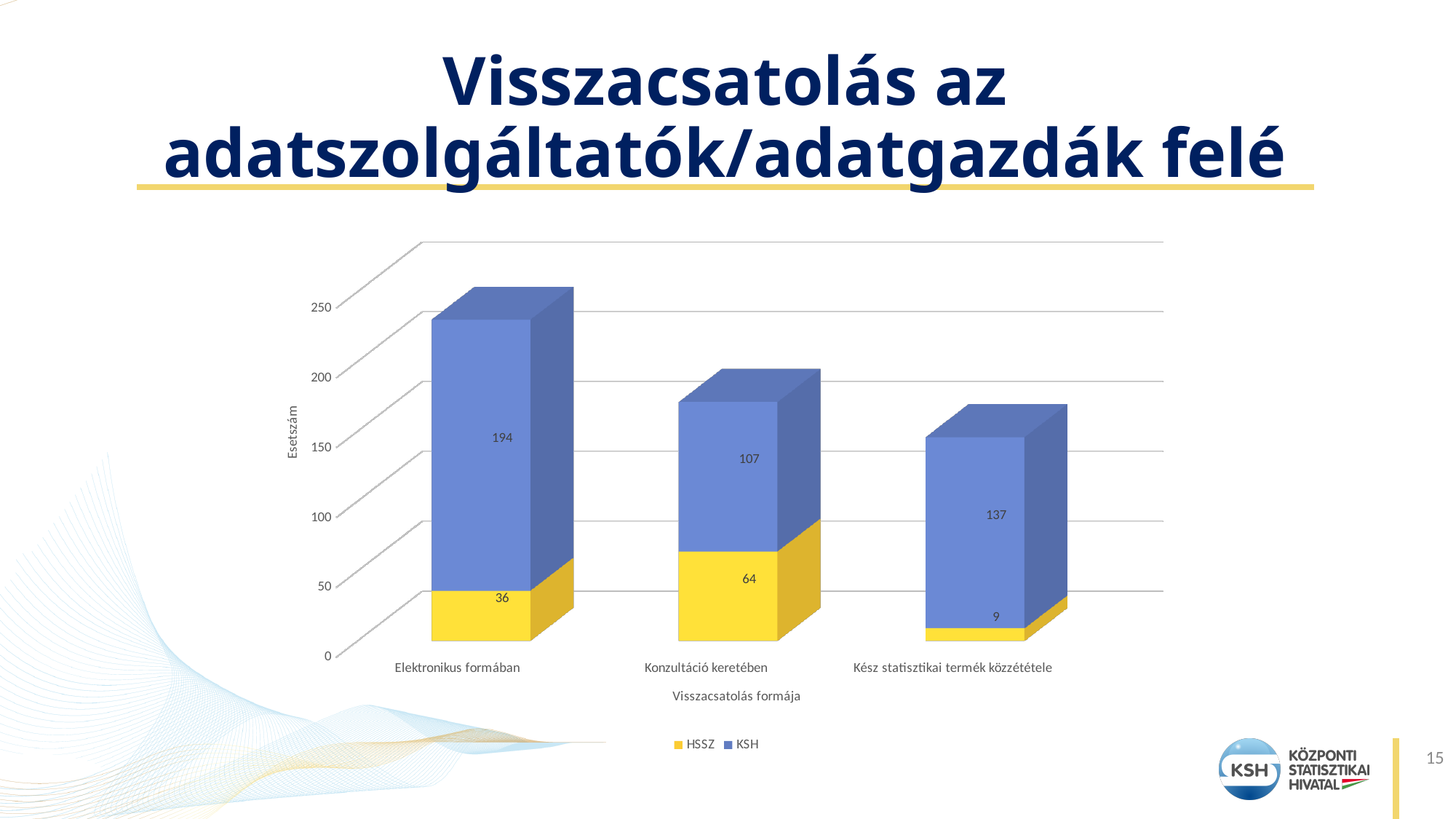
How many categories are shown on the x axis? 3 What is the difference between the KSH values for Elektronikus formában and Konzultáció keretében? 87 What is the label of the vertical axis? Esetszám What is the HSSZ value for Kész statisztikai termék közzététele? 9 What is the KSH value for Elektronikus formában? 194 What is the HSSZ value for Konzultáció keretében? 64 What is the total of the stacked bar for Kész statisztikai termék közzététele? 146 What is the total of the stacked bar for Konzultáció keretében? 171 How many series does the legend list? 2 Which is larger, the HSSZ value for Elektronikus formában or for Konzultáció keretében? Konzultáció keretében Which category has the lowest HSSZ value? Kész statisztikai termék közzététele Which category has the highest KSH value? Elektronikus formában